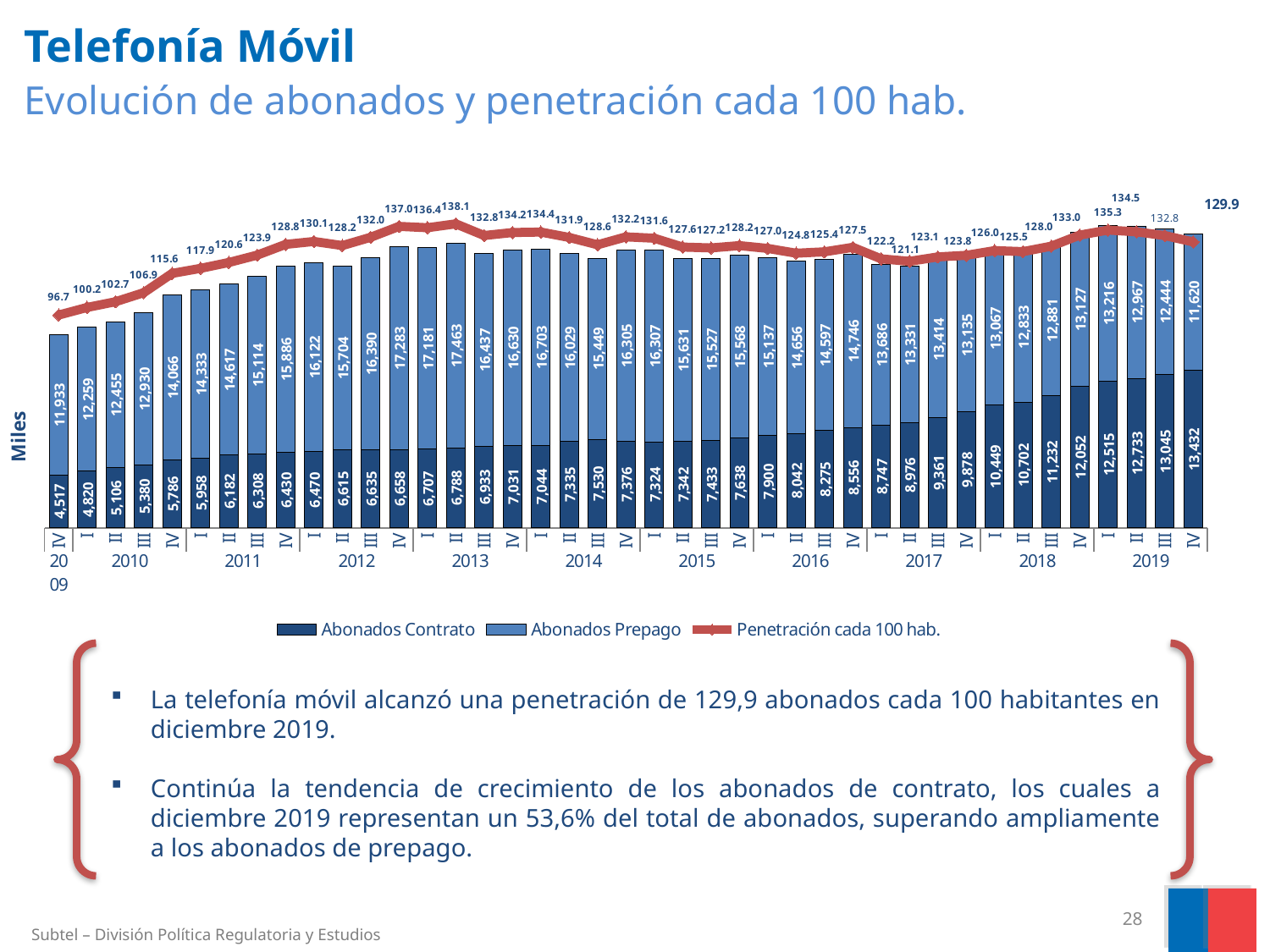
What is the value of Abonados Contrato for IV 2019? 13,432 What is the Penetración cada 100 hab. value for IV 2009? 96.7 How many series does the legend list? 3 Do the Abonados Contrato values rise or fall from IV 2009 to IV 2019? Rise What is the total of Abonados Contrato and Abonados Prepago for IV 2019? 25,052 In which quarter is Abonados Contrato lowest? IV 2009 (4,517) What kind of chart is shown? Stacked bar chart with a line By how much did Abonados Contrato increase from IV 2009 to IV 2019? 8,915 In IV 2019, which is larger: Abonados Contrato or Abonados Prepago? Abonados Contrato In which quarter does Penetración cada 100 hab. reach its highest value, and what is it? II 2013, 138.1 What is the highest value of Abonados Prepago shown, and in which quarter? 17,463 in II 2013 What is the value of Abonados Prepago for IV 2019? 11,620